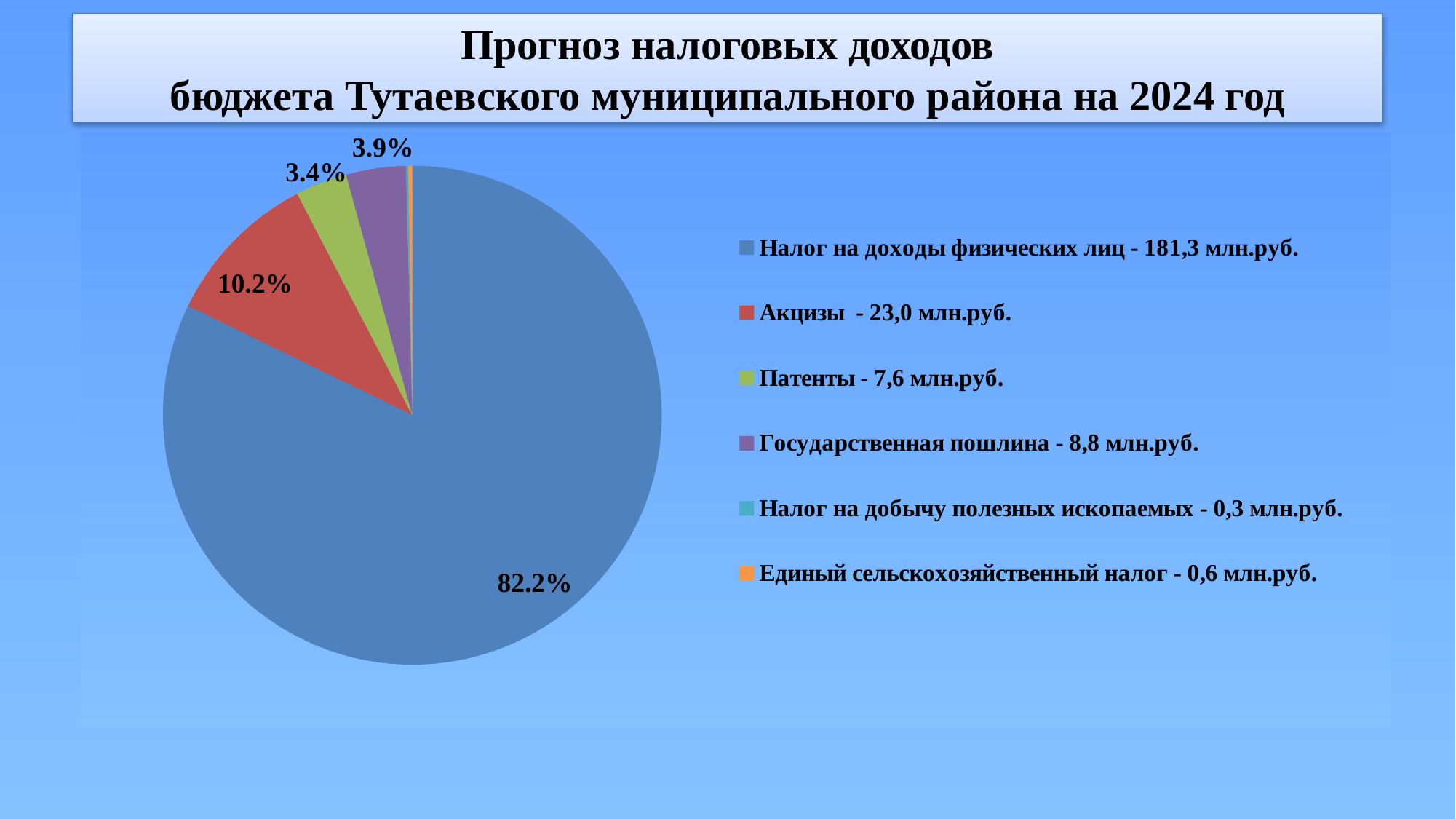
How many categories does the legend of the pie chart list? 6 What share of the pie does Государственная пошлина take? 3.9% Which slice is larger: Патенты or Государственная пошлина? Государственная пошлина What kind of chart is shown on the slide? pie chart What amount in млн.руб. does the legend give for Налог на добычу полезных ископаемых? 0,3 млн.руб. What is the title of the slide? Прогноз налоговых доходов бюджета Тутаевского муниципального района на 2024 год What share of the pie does Акцизы take? 10.2% Which category has the largest slice of the pie? Налог на доходы физических лиц What is the difference in percentage points between the Акцизы slice and the Патенты slice? 6.8 What share of the pie does Налог на доходы физических лиц take? 82.2% What amount in млн.руб. does the legend give for Акцизы? 23,0 млн.руб.